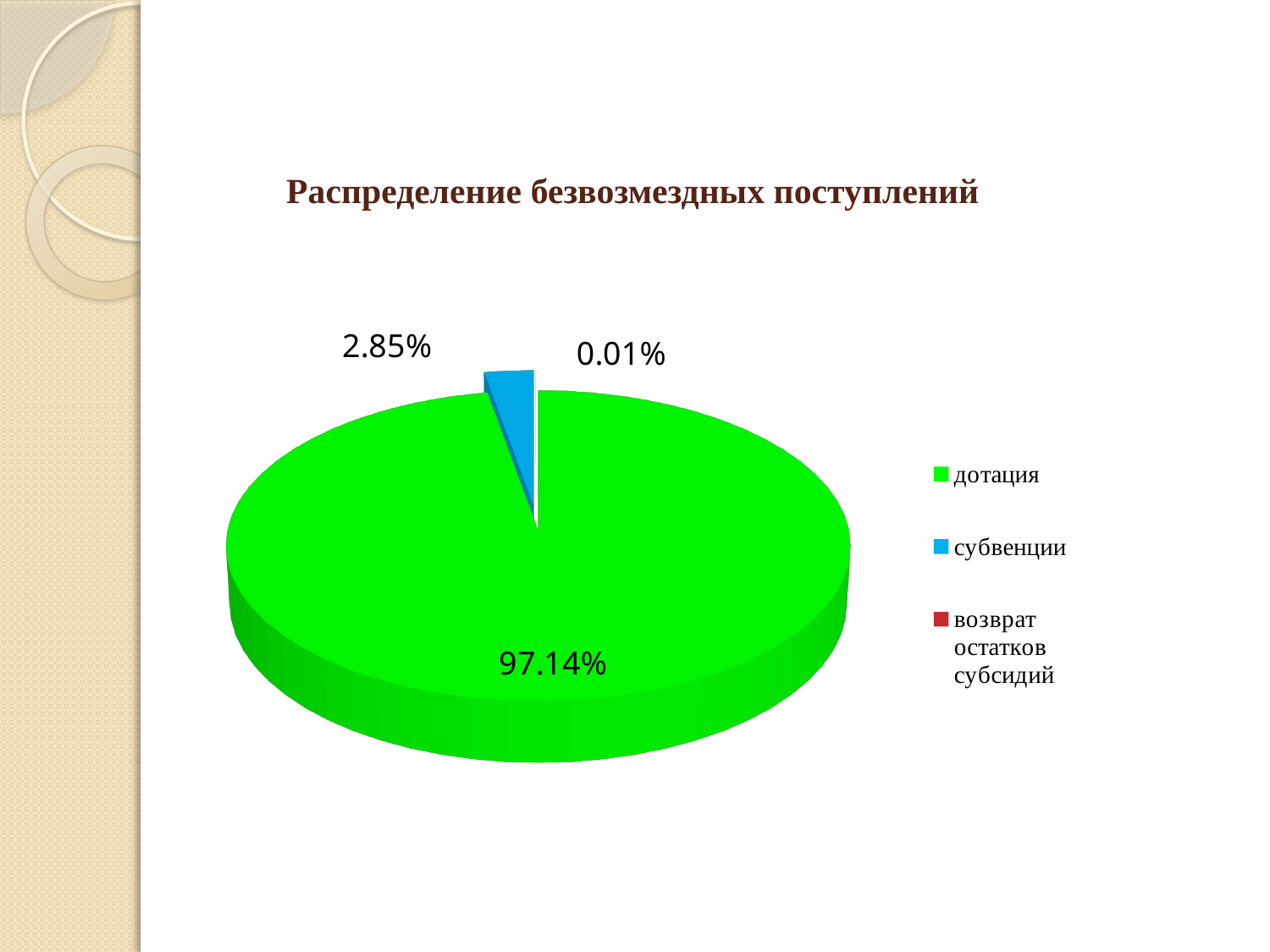
What kind of chart is shown on the slide? pie chart How many categories does the legend list? 3 What is the difference in percentage points between субвенции and возврат остатков субсидий? 2.84 Which category has the smallest slice of the pie? возврат остатков субсидий What share of the pie does субвенции have? 2.85% What share of the pie does дотация have? 97.14% What share of the pie does возврат остатков субсидий have? 0.01% Which is larger, the share for субвенции or the share for возврат остатков субсидий? субвенции Which category has the largest slice of the pie? дотация What is the difference in percentage points between дотация and субвенции? 94.29 What colour is the slice for субвенции? blue What is the title of the chart? Распределение безвозмездных поступлений